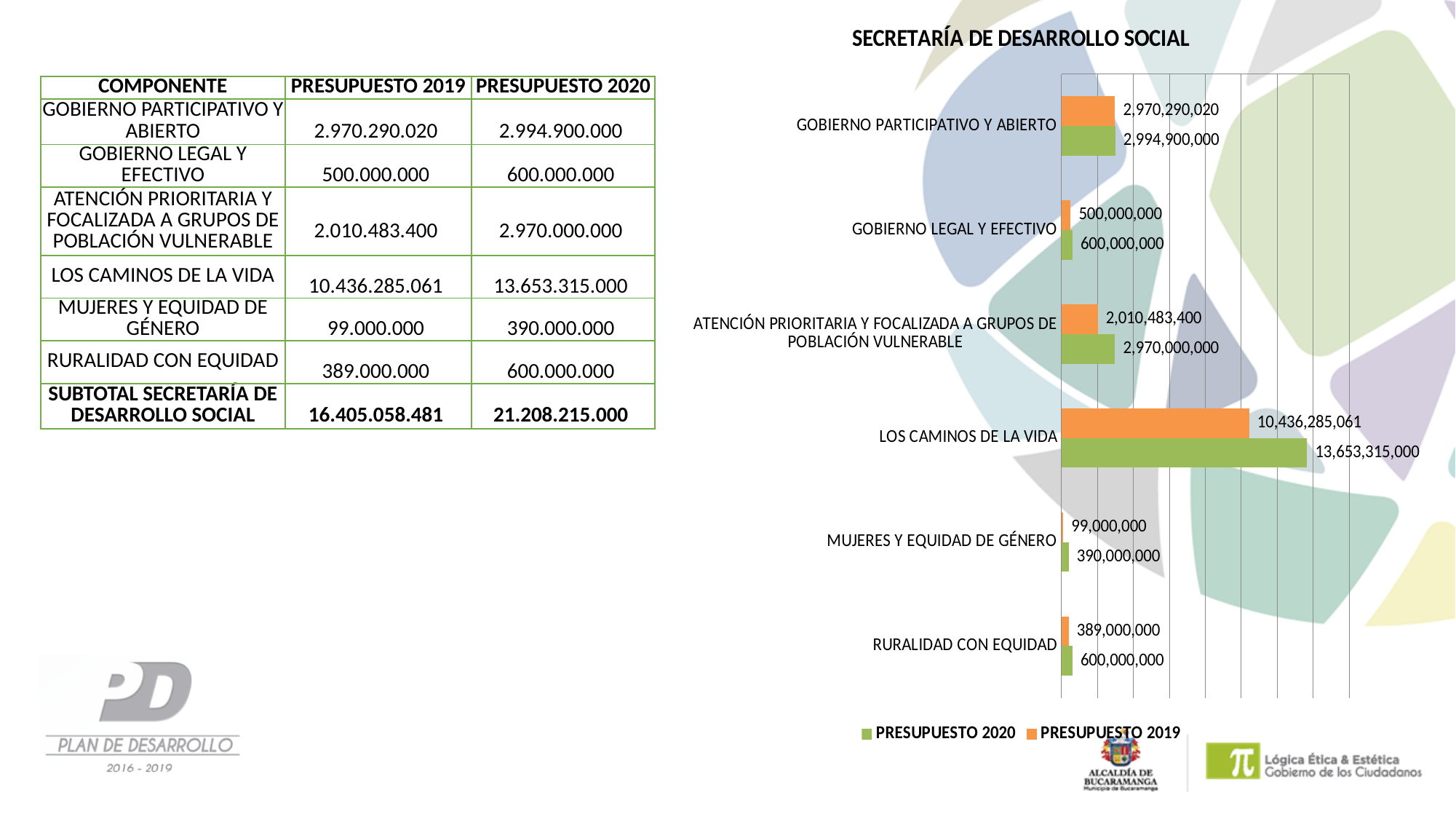
What is the PRESUPUESTO 2020 value for ATENCIÓN PRIORITARIA Y FOCALIZADA A GRUPOS DE POBLACIÓN VULNERABLE in the chart? 2,970,000,000 Which colour represents PRESUPUESTO 2020 in the chart? Green What is the PRESUPUESTO 2019 value for MUJERES Y EQUIDAD DE GÉNERO in the chart? 99,000,000 What is the PRESUPUESTO 2019 value for LOS CAMINOS DE LA VIDA in the chart? 10,436,285,061 What kind of chart is shown on the slide? Bar chart Which component has the highest PRESUPUESTO 2020 value in the chart? LOS CAMINOS DE LA VIDA Which component has the lowest PRESUPUESTO 2019 value in the chart? MUJERES Y EQUIDAD DE GÉNERO What is the difference between the PRESUPUESTO 2020 and PRESUPUESTO 2019 values for MUJERES Y EQUIDAD DE GÉNERO? 291,000,000 What is the difference between the PRESUPUESTO 2020 and PRESUPUESTO 2019 values for LOS CAMINOS DE LA VIDA? 3,217,029,939 How many components are shown in the chart? 6 How many series does the chart legend list? 2 Which has the larger PRESUPUESTO 2019 value: GOBIERNO PARTICIPATIVO Y ABIERTO or ATENCIÓN PRIORITARIA Y FOCALIZADA A GRUPOS DE POBLACIÓN VULNERABLE? GOBIERNO PARTICIPATIVO Y ABIERTO